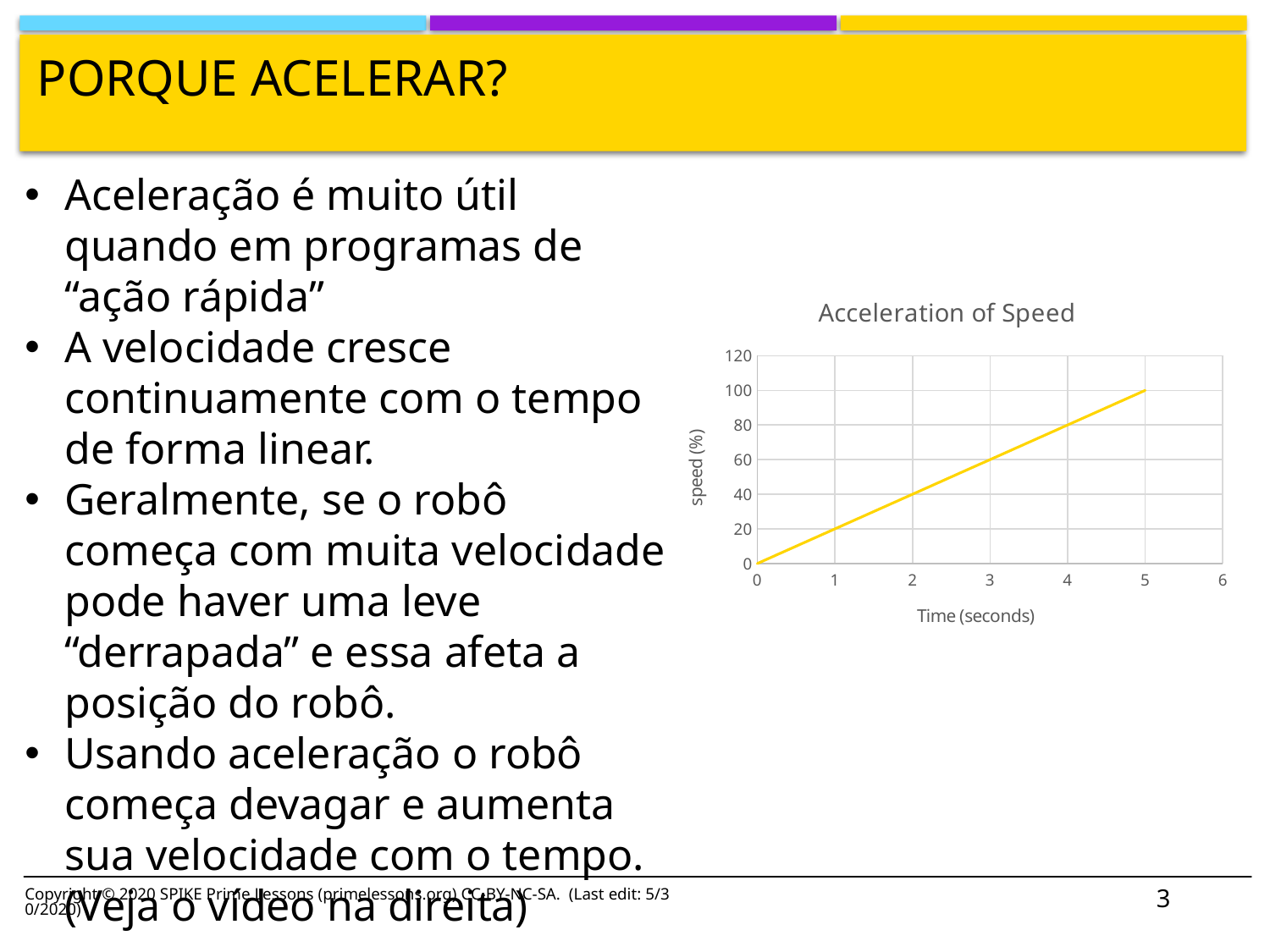
According to the chart, what is the speed (%) at 0 seconds? 0 According to the chart, what is the speed (%) at 4 seconds? 80 What is the difference between the speed at 5 seconds and the speed at 0 seconds? 100 Is the speed at 1 second greater or less than 60? less What kind of chart is shown on the slide? line chart According to the chart, what is the speed (%) at 5 seconds? 100 What is the label of the x axis of the chart? Time (seconds) What is the title of the chart? Acceleration of Speed Does the speed rise or fall as time increases along the x axis? rise Is the speed at 3 seconds greater or less than 40? greater Which is larger, the speed at 2 seconds or the speed at 4 seconds? the speed at 4 seconds According to the chart, what is the speed (%) at 2 seconds? 40